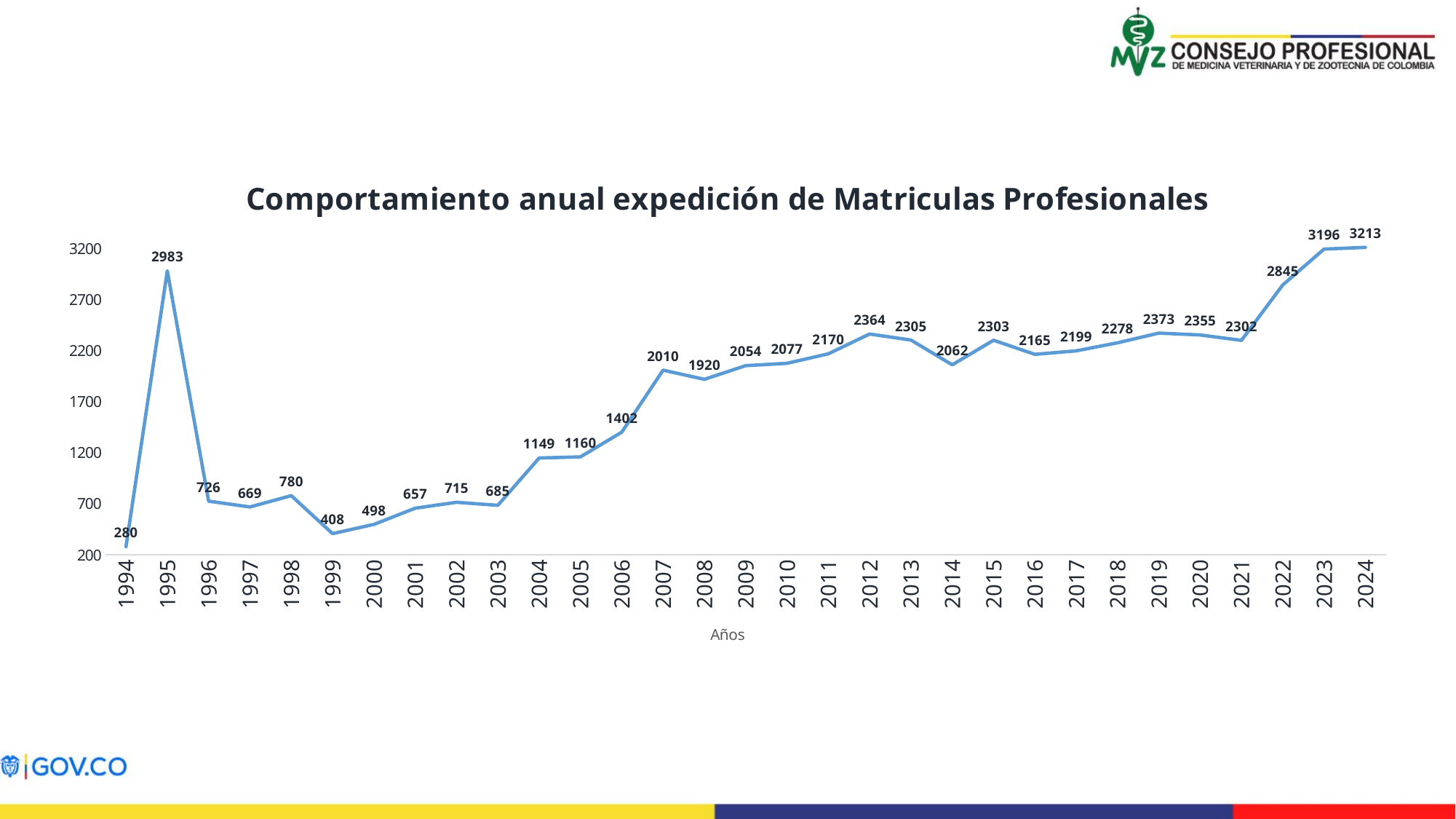
How many years are plotted on the chart? 31 Which is larger, the value for 2012 or the value for 2019? 2019 What is the difference between the values for 2022 and 2021? 543 What is the difference between the values for 2024 and 2023? 17 What is the title of the chart? Comportamiento anual expedición de Matriculas Profesionales What kind of chart is shown on the slide? line chart What value is shown for 2007? 2010 What value is shown for 2024? 3213 Which year has the highest value? 2024 Is the value for 1999 greater or less than 700? less What value is shown for 1995? 2983 Which year has the lowest value? 1994